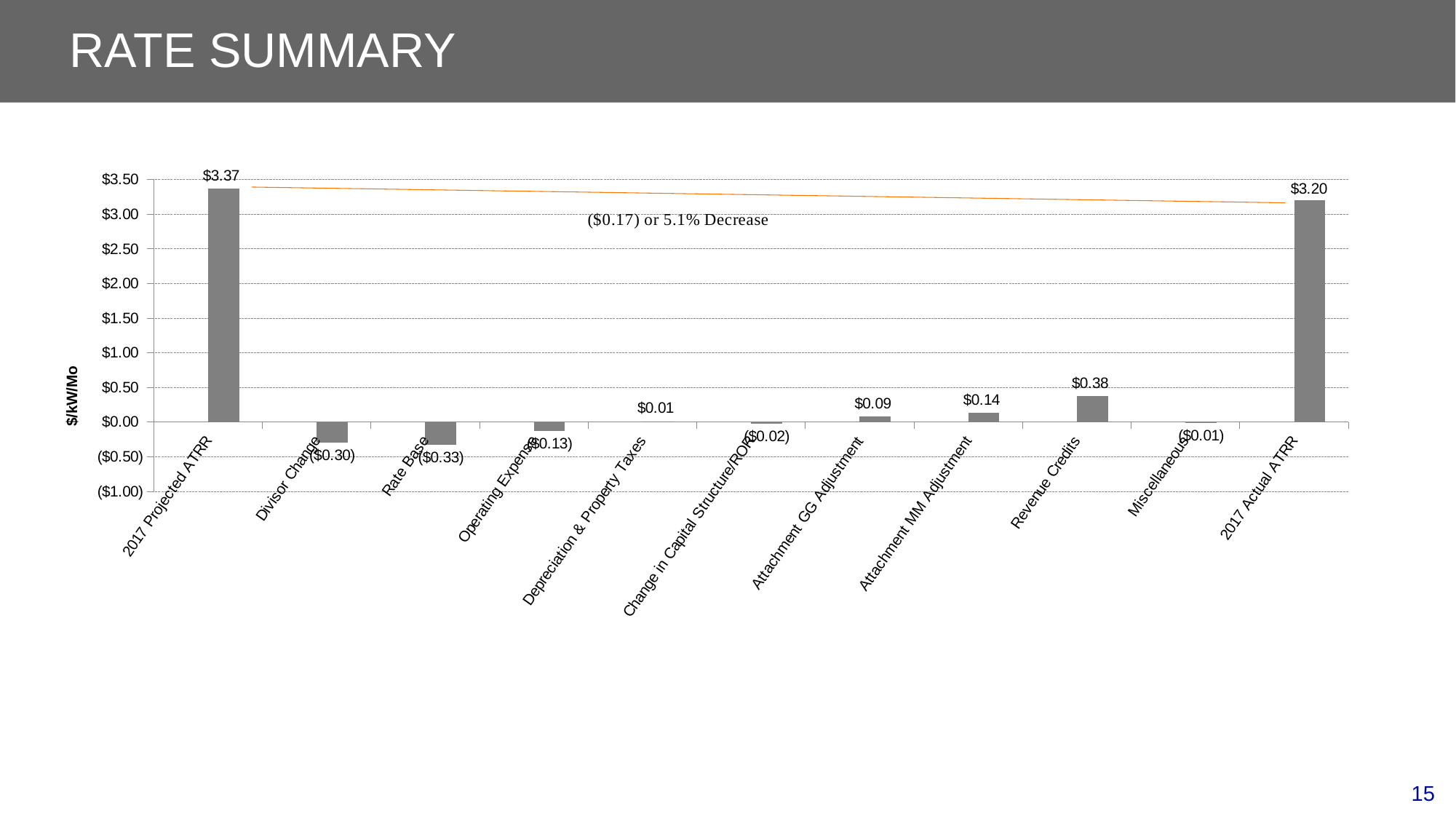
What is the value for Rate Base? ($0.33) What is the difference between 2017 Projected ATRR and 2017 Actual ATRR? $0.17 What is the value for 2017 Projected ATRR? $3.37 How many categories are shown on the x axis? 11 What is the value for 2017 Actual ATRR? $3.20 What is the value for Attachment MM Adjustment? $0.14 Which is larger, the value for Attachment GG Adjustment or the value for Attachment MM Adjustment? Attachment MM Adjustment Which category has the lowest value? Rate Base What is the label on the vertical axis? $/kW/Mo What is the value for Revenue Credits? $0.38 What kind of chart is shown on the slide? Bar chart Which category has the highest value? 2017 Projected ATRR